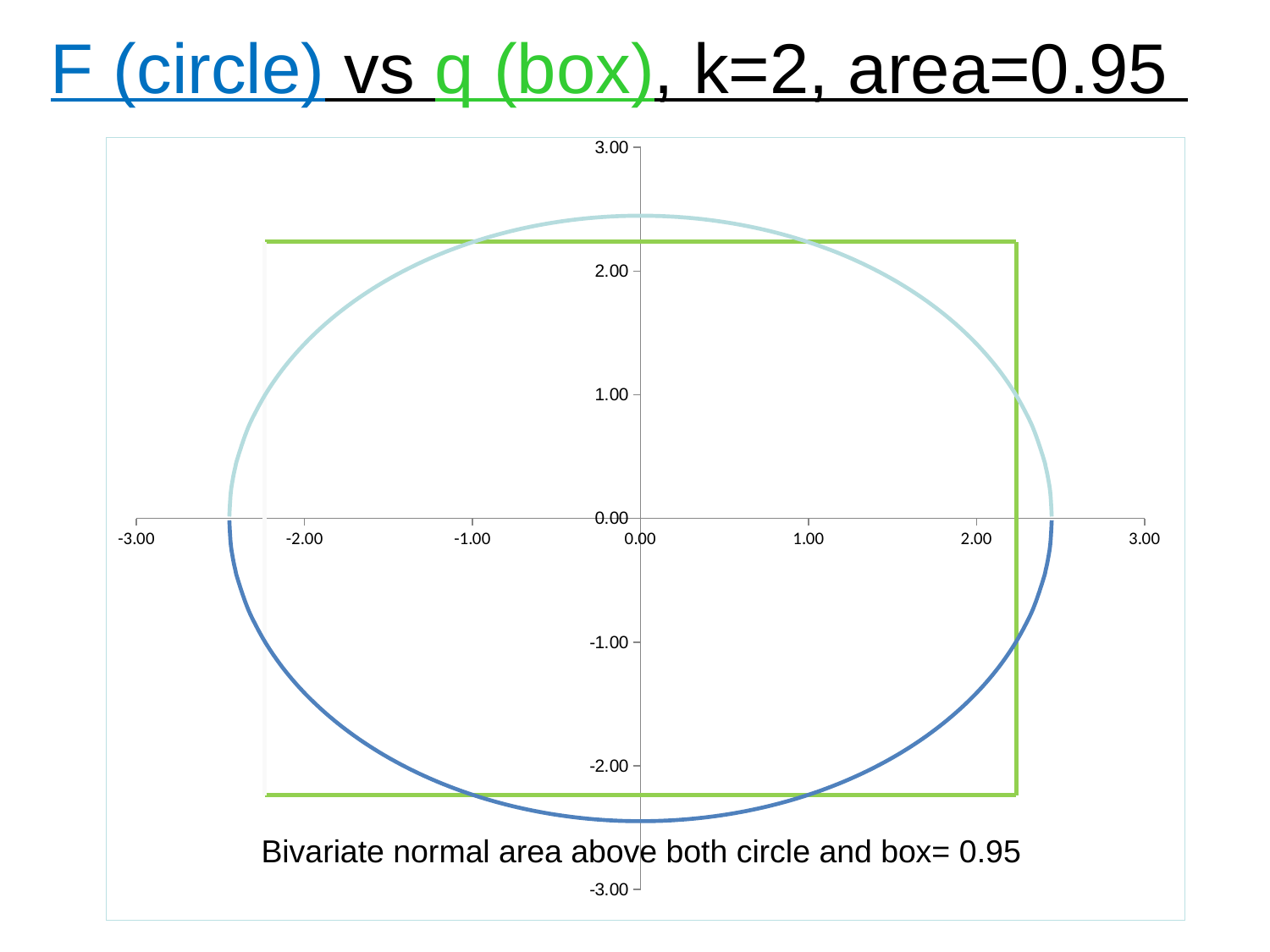
Is the top edge of the box at a y value greater or less than 3.00? less Is the right edge of the box at an x value greater or less than 2.00? greater Is the rightmost x value reached by the circle greater or less than 3.00? less Which extends further along the positive x axis, the circle or the box? the circle What colour is the box drawn in on the chart? green What kind of chart is shown on the slide? line chart What is the minimum value shown on the y axis? -3.00 What is the title of the slide above the chart? F (circle) vs q (box), k=2, area=0.95 What is the maximum value shown on the x axis? 3.00